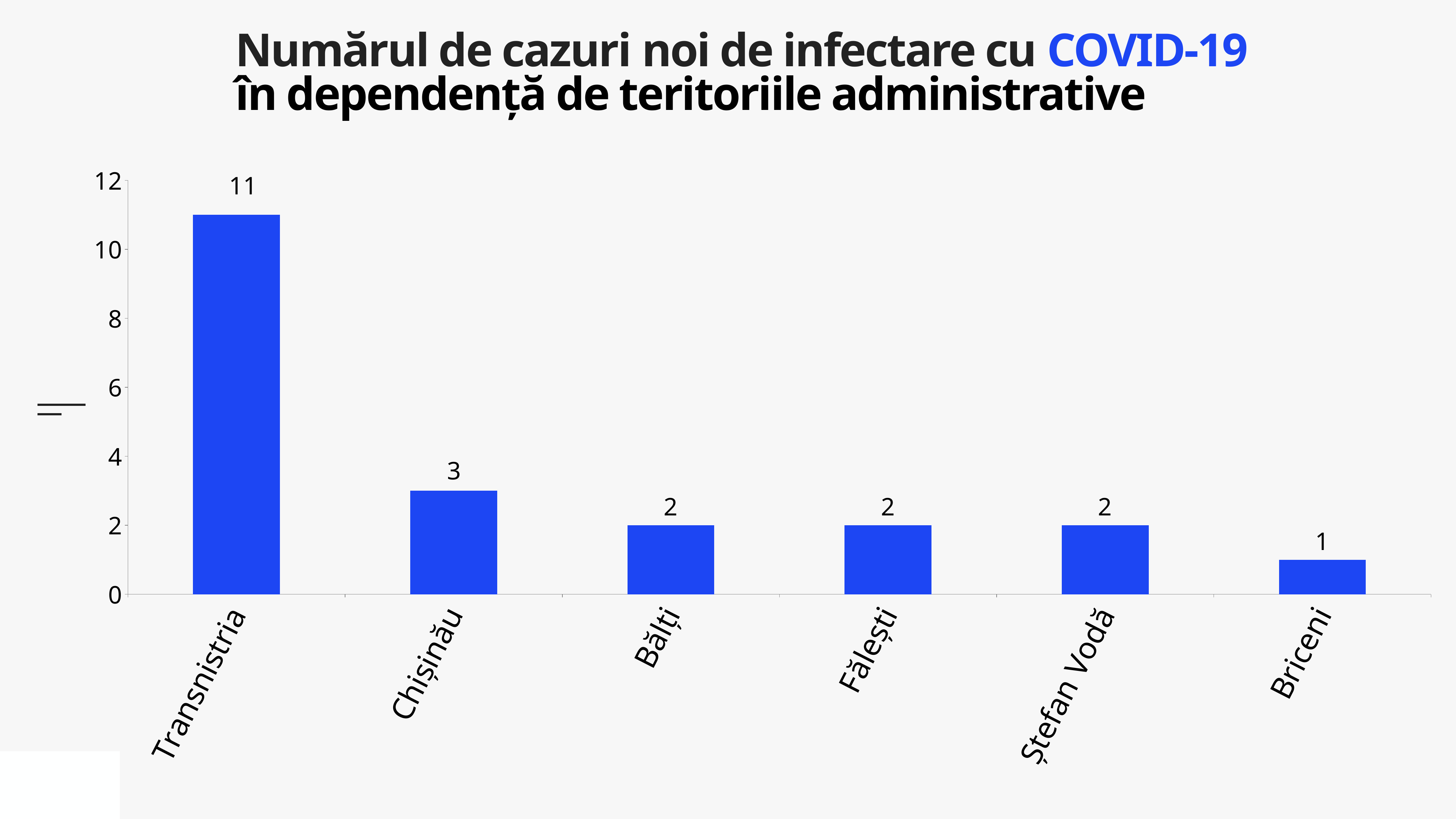
What kind of chart is shown on the slide? Bar chart Which has more new cases, Chișinău or Bălți? Chișinău What is the maximum value shown on the vertical axis? 12 Is the value for Transnistria greater or less than 10? greater Which territory has the lowest number of new cases? Briceni What is the number of new COVID-19 cases for Briceni? 1 What is the number of new COVID-19 cases for Transnistria? 11 What is the difference between the number of new cases in Transnistria and Chișinău? 8 How many territories are shown on the chart? 6 What is the number of new COVID-19 cases for Fălești? 2 What is the number of new COVID-19 cases for Chișinău? 3 Which territory has the highest number of new cases? Transnistria